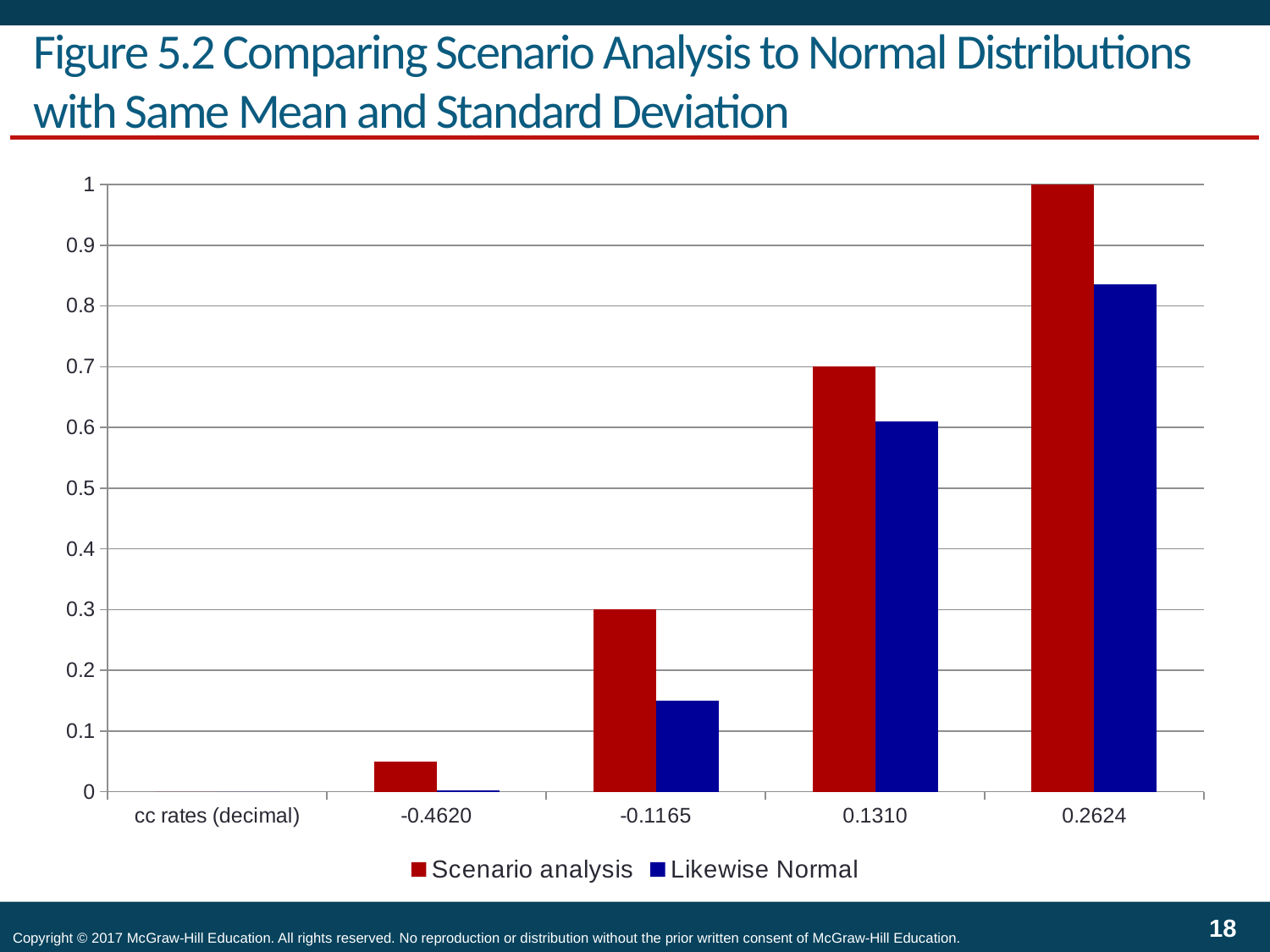
At the cc rate 0.1310, which series has the larger value, Scenario analysis or Likewise Normal? Scenario analysis Do the Scenario analysis values rise or fall as the cc rate increases along the x axis? Rise What is the difference between the Scenario analysis values at 0.2624 and 0.1310? 0.3 What type of chart is shown on the slide? Bar chart What is the Scenario analysis value at the cc rate 0.1310? 0.7 At which cc rate is the Likewise Normal value lowest? -0.4620 What is the Scenario analysis value at the cc rate -0.1165? 0.3 What colour are the Scenario analysis bars? Red What is the Scenario analysis value at the cc rate 0.2624? 1 Is the Likewise Normal value at the cc rate 0.2624 greater or less than 0.8? greater How many series does the legend list? 2 At which cc rate is the Scenario analysis value highest? 0.2624